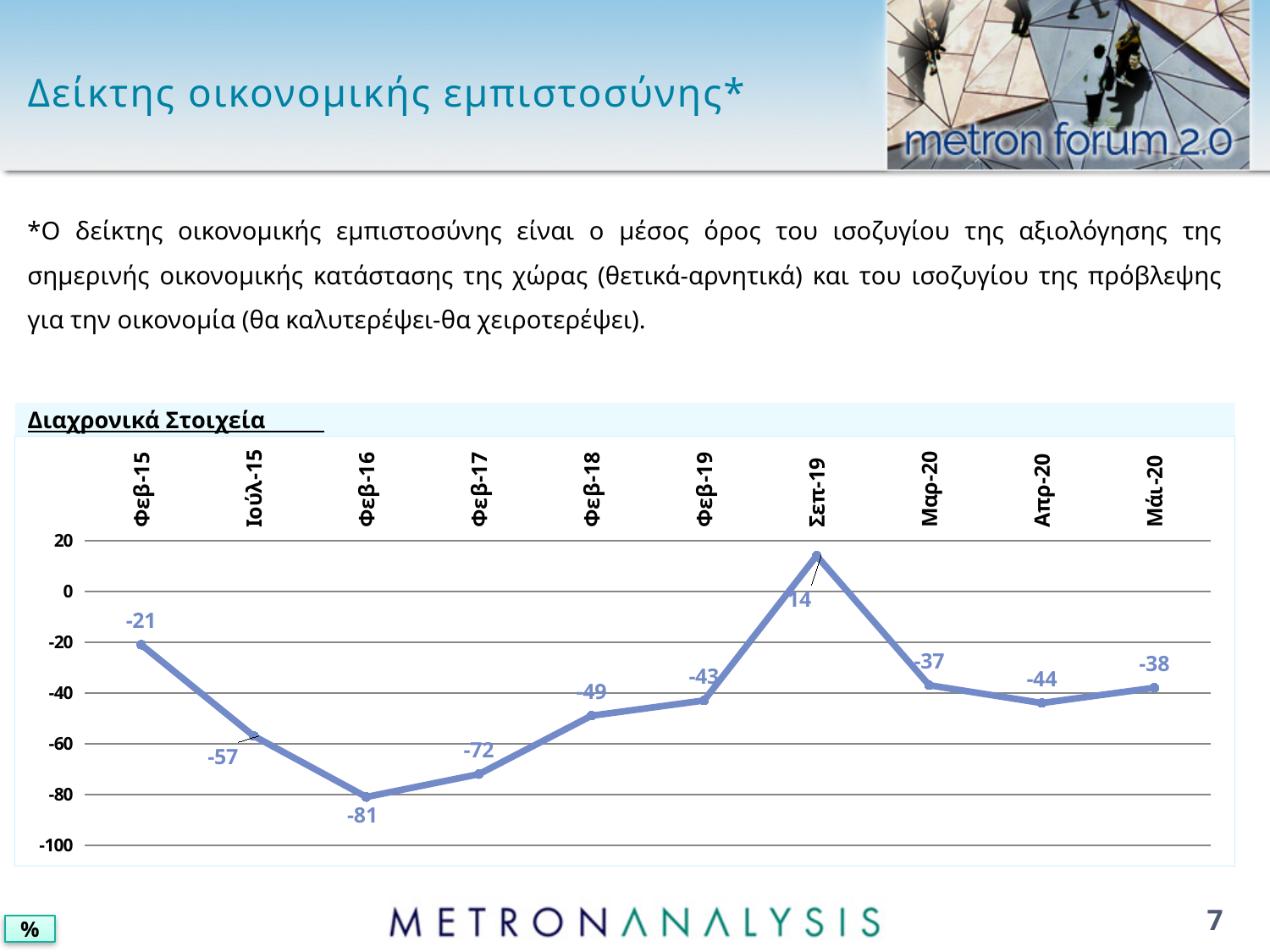
What is the difference between the index values for Σεπ-19 and Μαρ-20? 51 What type of chart is shown on the slide? Line chart What is the value of the economic confidence index for Μάι-20? -38 Which is larger, the index value for Φεβ-18 or for Φεβ-19? Φεβ-19 Which period has the lowest value of the economic confidence index? Φεβ-16 Does the index rise or fall between Φεβ-16 and Σεπ-19? Rise What is the value of the economic confidence index for Φεβ-17? -72 What is the title shown above the chart? Διαχρονικά Στοιχεία What is the value of the economic confidence index for Σεπ-19? 14 Which period has the highest value of the economic confidence index? Σεπ-19 How many time periods are plotted on the chart? 10 What is the value of the economic confidence index for Φεβ-15? -21